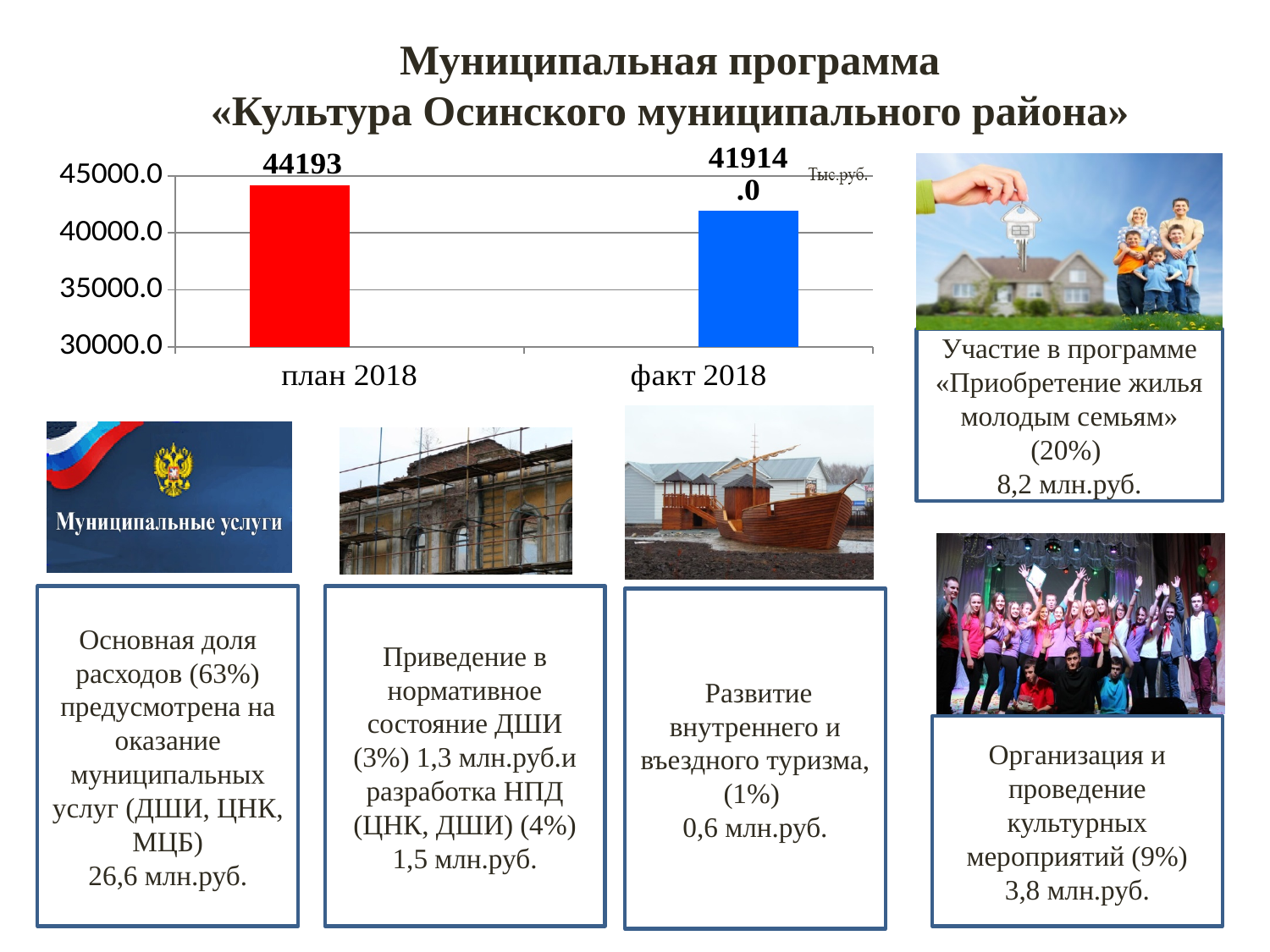
Which category has the highest value? план 2018 What is the value for план 2018? 44193 What is the difference between the план 2018 and факт 2018 values? 2279 What kind of chart is shown on the slide? bar chart Is the value for факт 2018 greater or less than 40000.0? greater Which category has the higher value, план 2018 or факт 2018? план 2018 What unit is indicated next to the chart? Тыс.руб. Do the values rise or fall from план 2018 to факт 2018? fall Which category has the lowest value? факт 2018 Is the value for план 2018 greater or less than 45000.0? less What is the value for факт 2018? 41914.0 How many categories are shown on the chart? 2